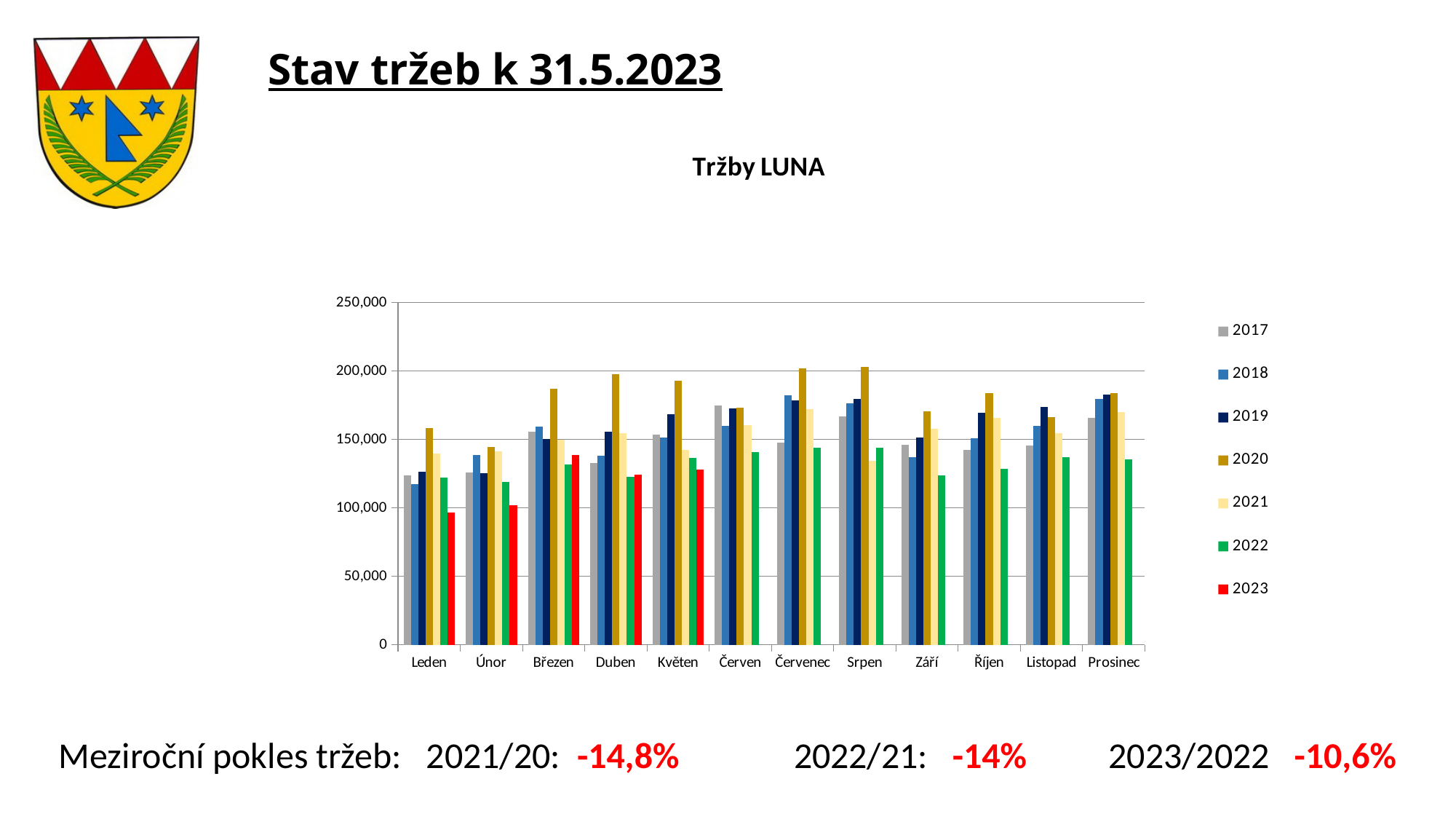
How many months are shown on the x axis? 12 Is the 2023 value for Leden greater or less than 100,000? less How many series does the legend list? 7 Is the 2020 value for Duben greater or less than 150,000? greater In which month is the 2023 value the highest? Březen For how many months does the chart show a 2023 bar? 5 Which colour represents the 2023 series in the legend? red Is the 2022 value for Leden greater or less than 150,000? less What kind of chart is shown on the slide? bar chart In which month is the 2023 value the lowest? Leden What is the title of the chart? Tržby LUNA In Březen, which is larger: the 2020 value or the 2022 value? 2020